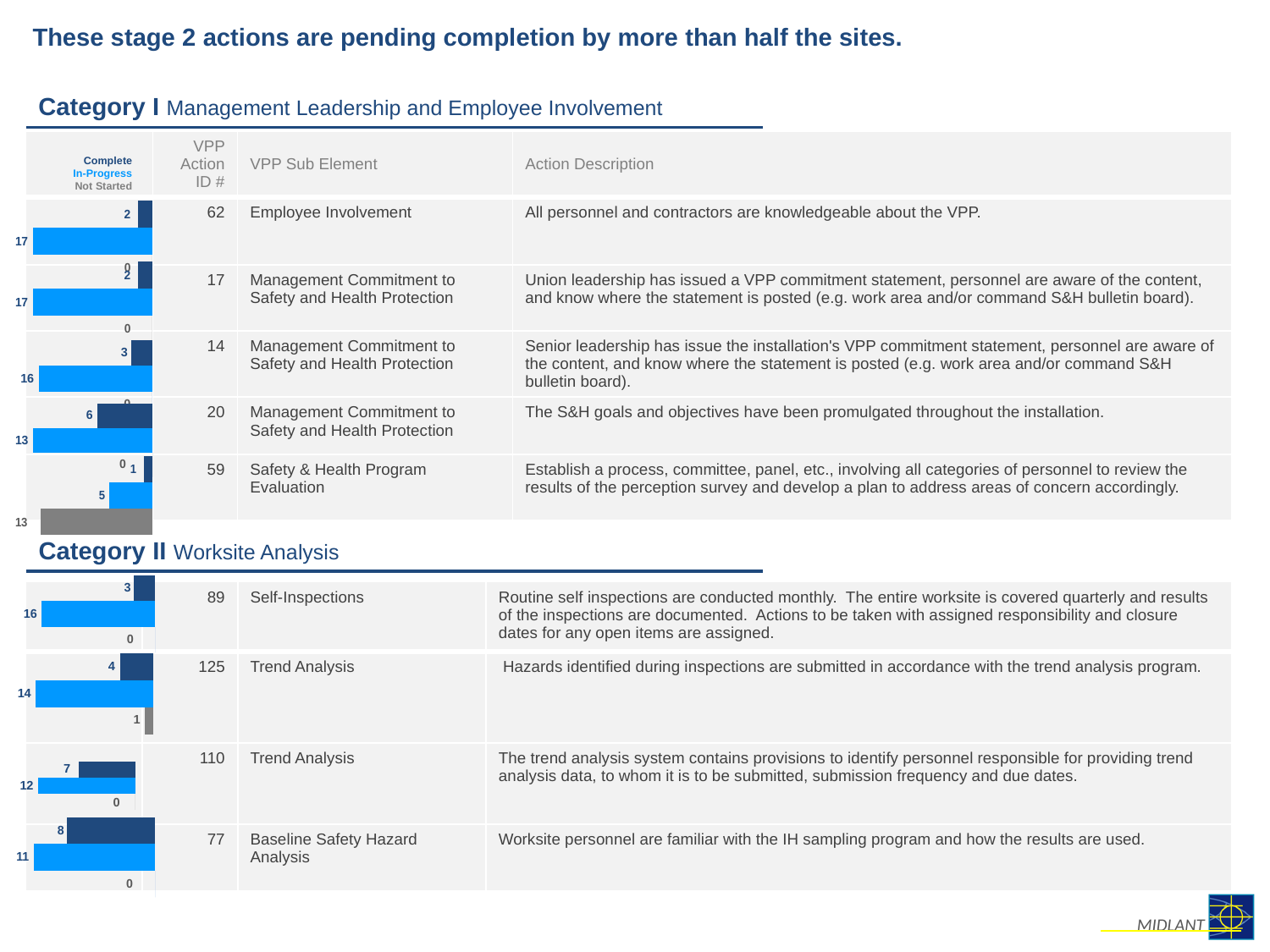
In the chart for VPP Action ID 77 (Baseline Safety Hazard Analysis), what is the difference between In-Progress and Complete sites? 3 In the chart for VPP Action ID 89 (Self-Inspections), how many sites are Complete? 3 In the chart for VPP Action ID 20, how many sites are Complete? 6 In the chart for VPP Action ID 125 (Trend Analysis), how many sites are Not Started? 1 How many status categories does the legend in the first column header list? 3 In the chart for VPP Action ID 62 (Employee Involvement), how many sites are In-Progress? 17 In the chart for VPP Action ID 14, how many sites are In-Progress? 16 In the chart for VPP Action ID 110, which is larger: the number of Complete sites or the number of In-Progress sites? In-Progress In the chart for VPP Action ID 59 (Safety & Health Program Evaluation), how many sites are Not Started? 13 What type of chart is used in the first column of the table to show site status? Bar chart In the chart for VPP Action ID 59, which status has the highest number of sites? Not Started In the chart for VPP Action ID 62 (Employee Involvement), how many sites are Complete? 2